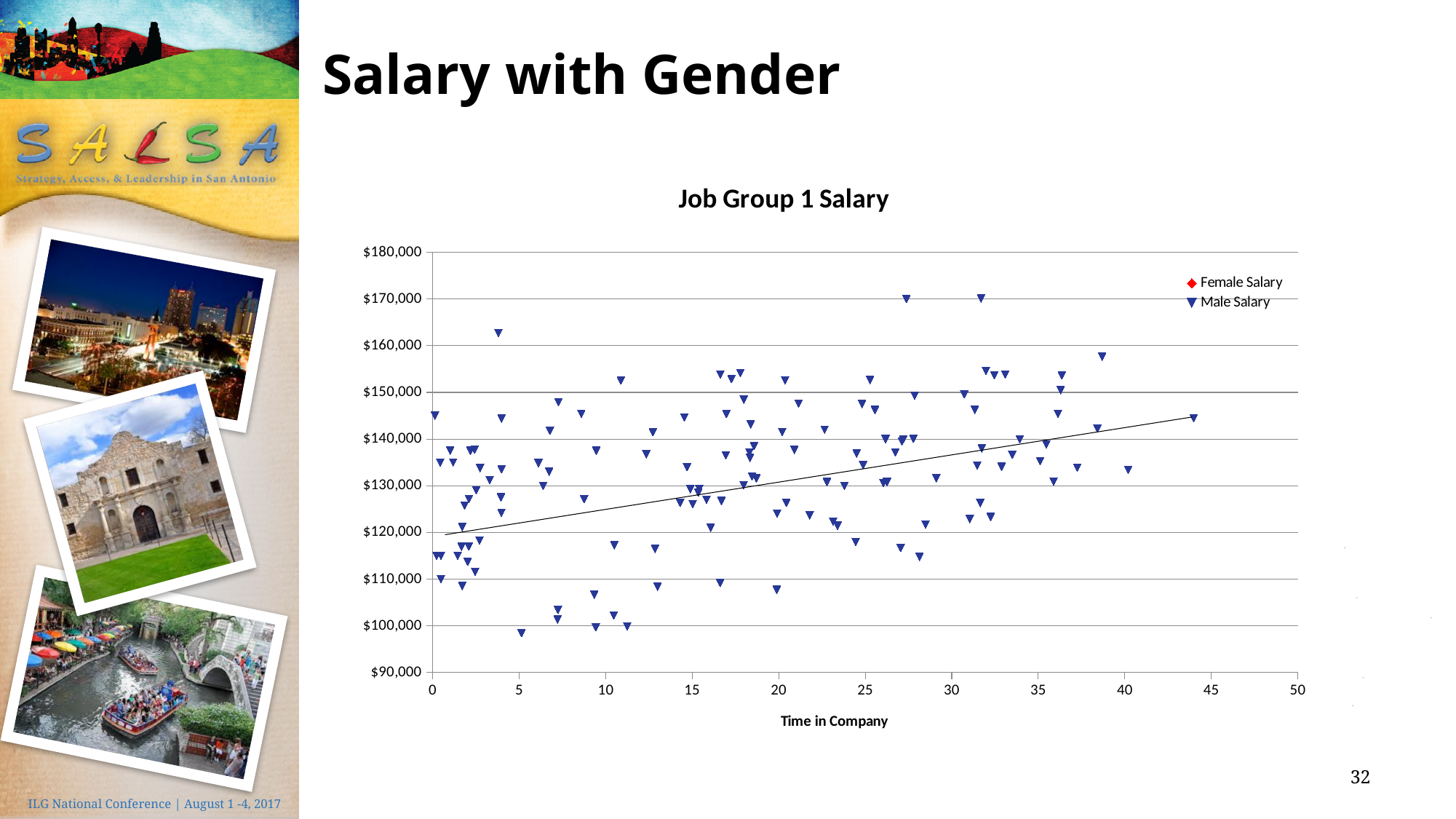
What is the label of the x axis? Time in Company What is the title of the chart? Job Group 1 Salary What is the highest value shown on the y axis? $180,000 Is the highest plotted Male Salary value greater or less than $160,000? greater How many series does the chart legend list? 2 What kind of chart is shown on the slide? Scatter chart Is the Male Salary trend line at Time in Company 40 greater or less than $140,000? greater Is the lowest plotted Male Salary value greater or less than $100,000? less Does the trend line for Male Salary rise or fall as Time in Company increases? Rises